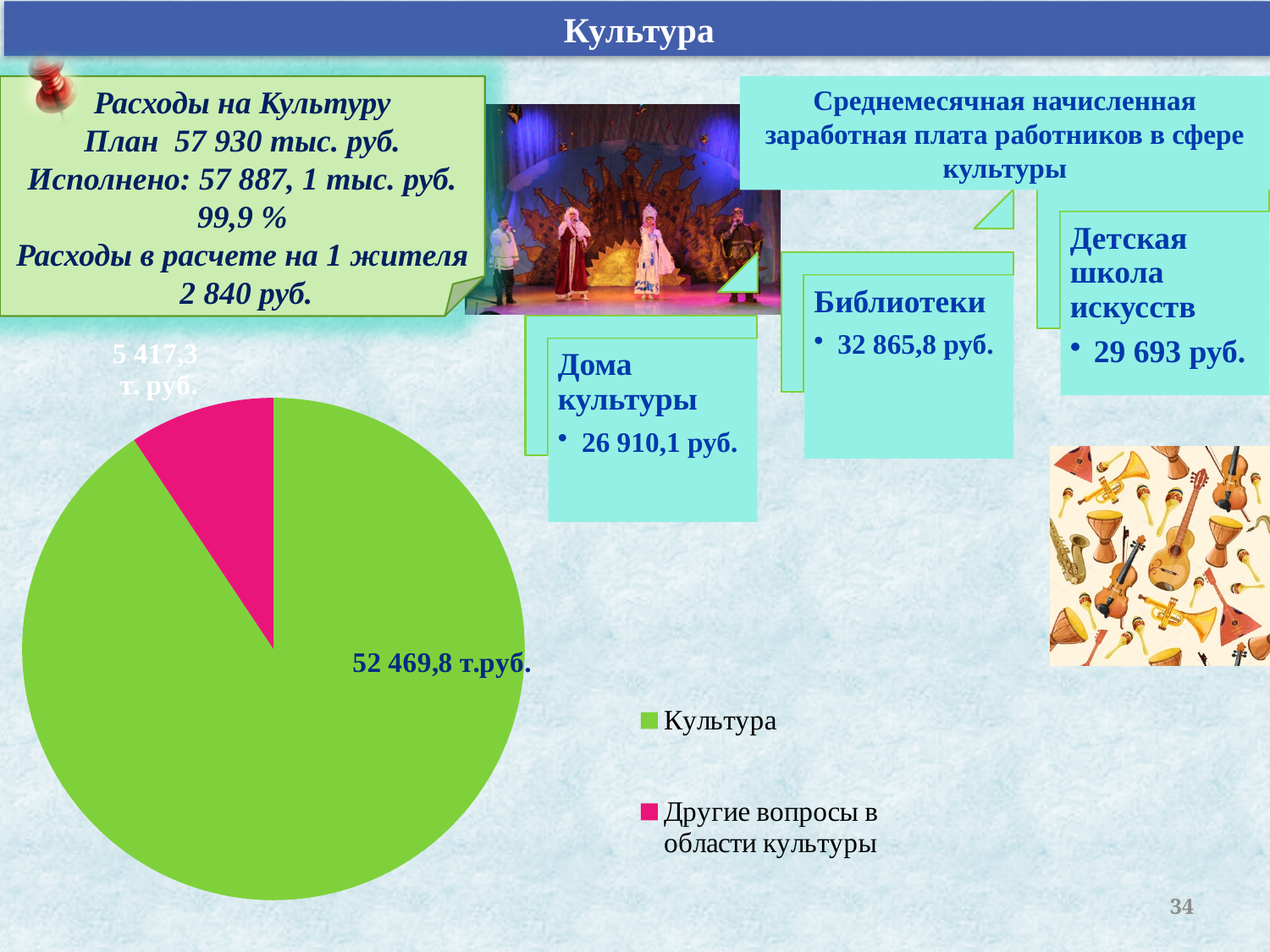
What kind of chart is shown on the slide? pie chart Which is larger in the pie chart: "Культура" or "Другие вопросы в области культуры"? Культура What colour is the "Культура" slice in the pie chart? green Which slice of the pie chart is the largest? Культура Which slice of the pie chart is the smallest? Другие вопросы в области культуры What is the value of the "Культура" slice in the pie chart? 52 469,8 т.руб. How many slices does the pie chart have? 2 How many entries does the legend of the pie chart list? 2 What is the difference between the "Культура" slice and the "Другие вопросы в области культуры" slice? 47 052,5 т.руб. What colour is the "Другие вопросы в области культуры" slice in the pie chart? pink What is the value of the "Другие вопросы в области культуры" slice in the pie chart? 5 417,3 т.руб. What is the total of the two slices in the pie chart? 57 887,1 т.руб.